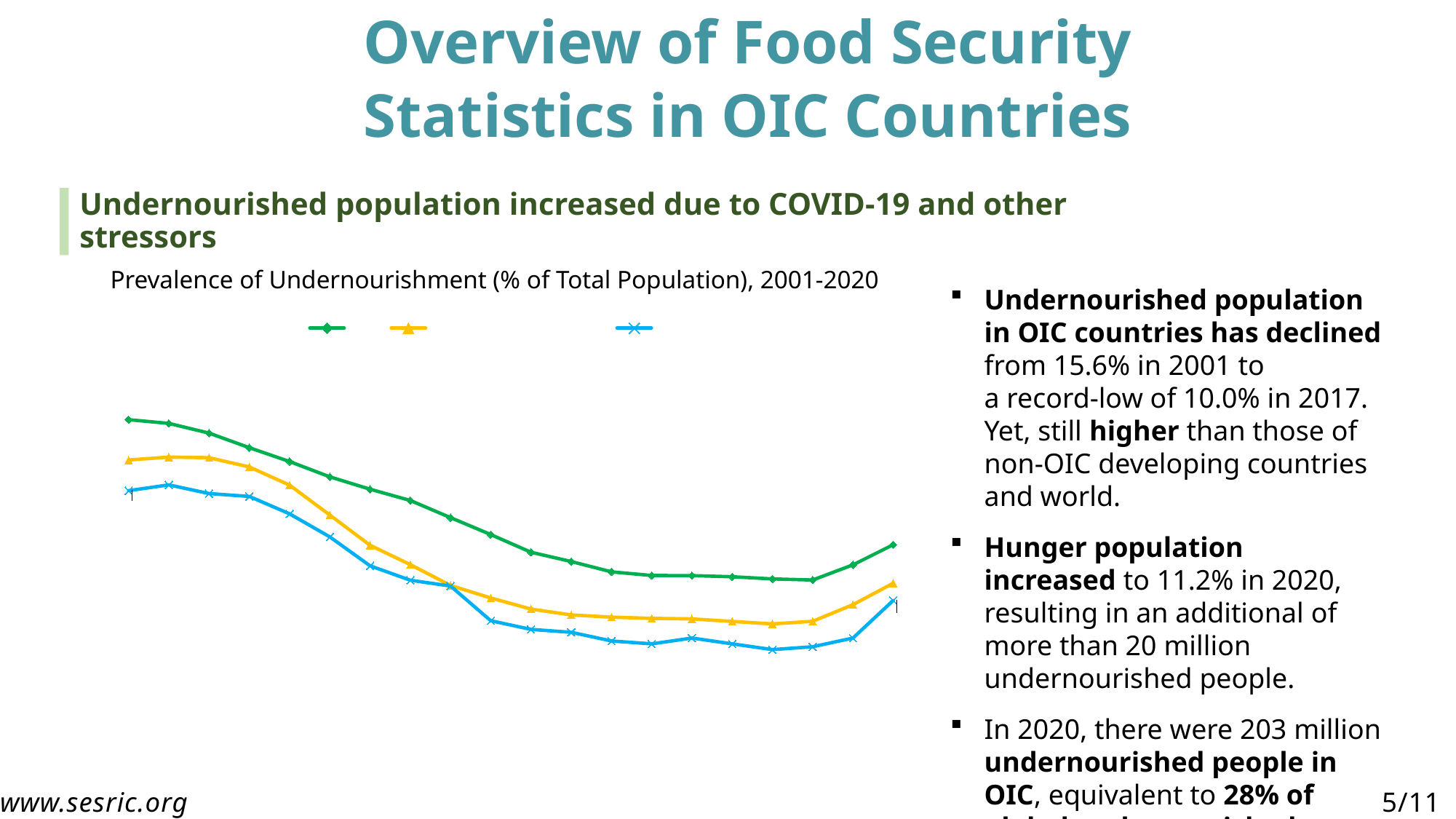
Do the lines rise or fall over the last few points at the right end of the chart? rise Which line is the lowest across the whole chart: the green, the yellow or the blue one? blue At the left end of the chart, is the green line above or below the yellow line? above Do the values of the green line mostly rise or fall from left to right across the chart? fall Which line is the highest across the whole chart: the green, the yellow or the blue one? green What colours are the three lines in the chart? green, yellow and blue What is the title of the chart? Prevalence of Undernourishment (% of Total Population), 2001-2020 How many series does the chart's legend list? 3 How many data points does each line in the chart have? 20 What kind of chart is shown on the slide? line chart